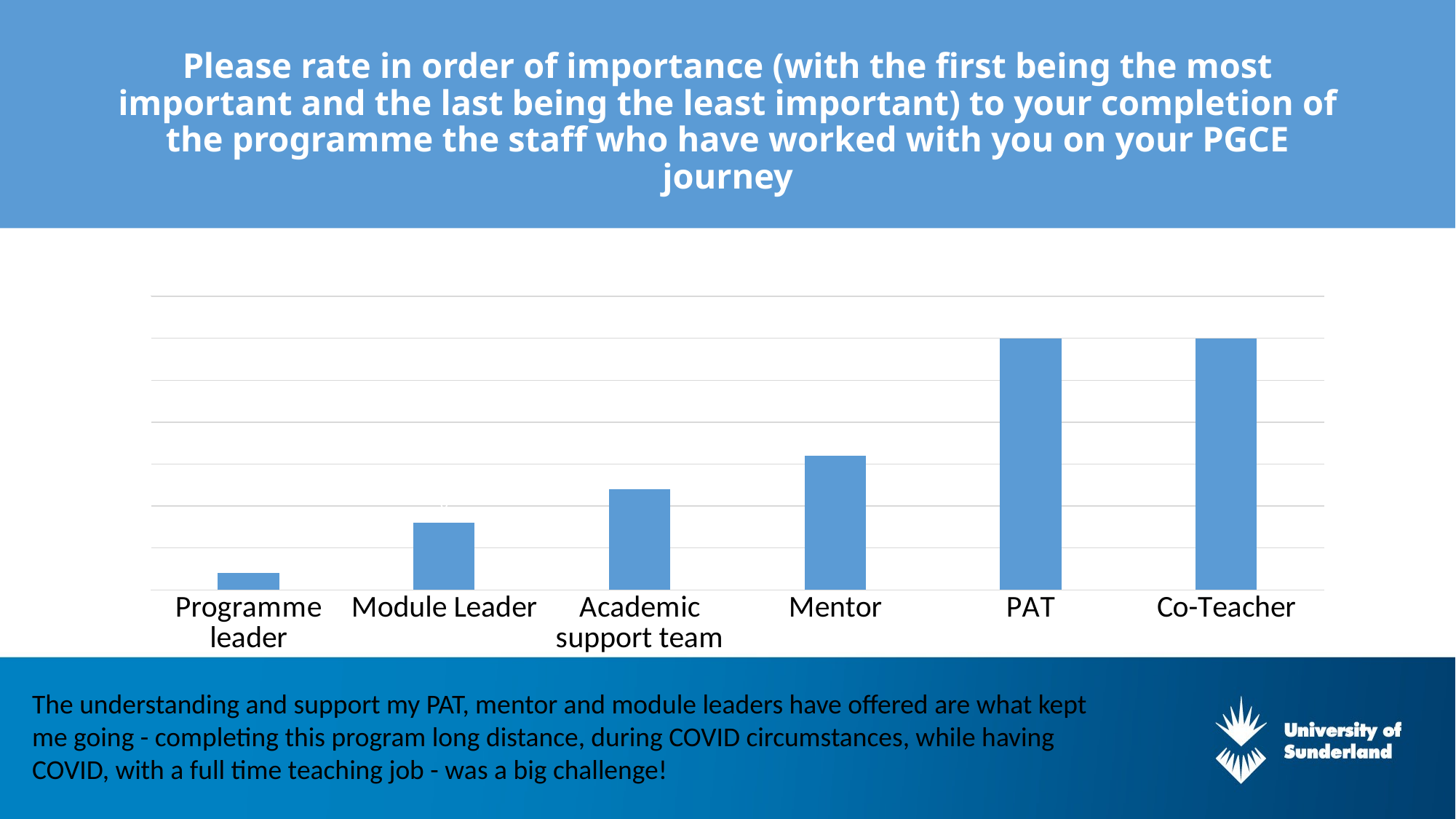
Do the bar values generally rise or fall moving from left to right along the x axis? rise What kind of chart is shown on the slide? bar chart Which category has the lowest bar in the chart? Programme leader Which is larger, the value for Module Leader or the value for Academic support team? Academic support team Is the bar for Mentor taller or shorter than the bar for Module Leader? taller Which category is plotted immediately to the right of Mentor? PAT How many categories are shown on the x axis of the chart? 6 What colour are the bars in the chart? blue Which is larger, the value for Academic support team or the value for Programme leader? Academic support team